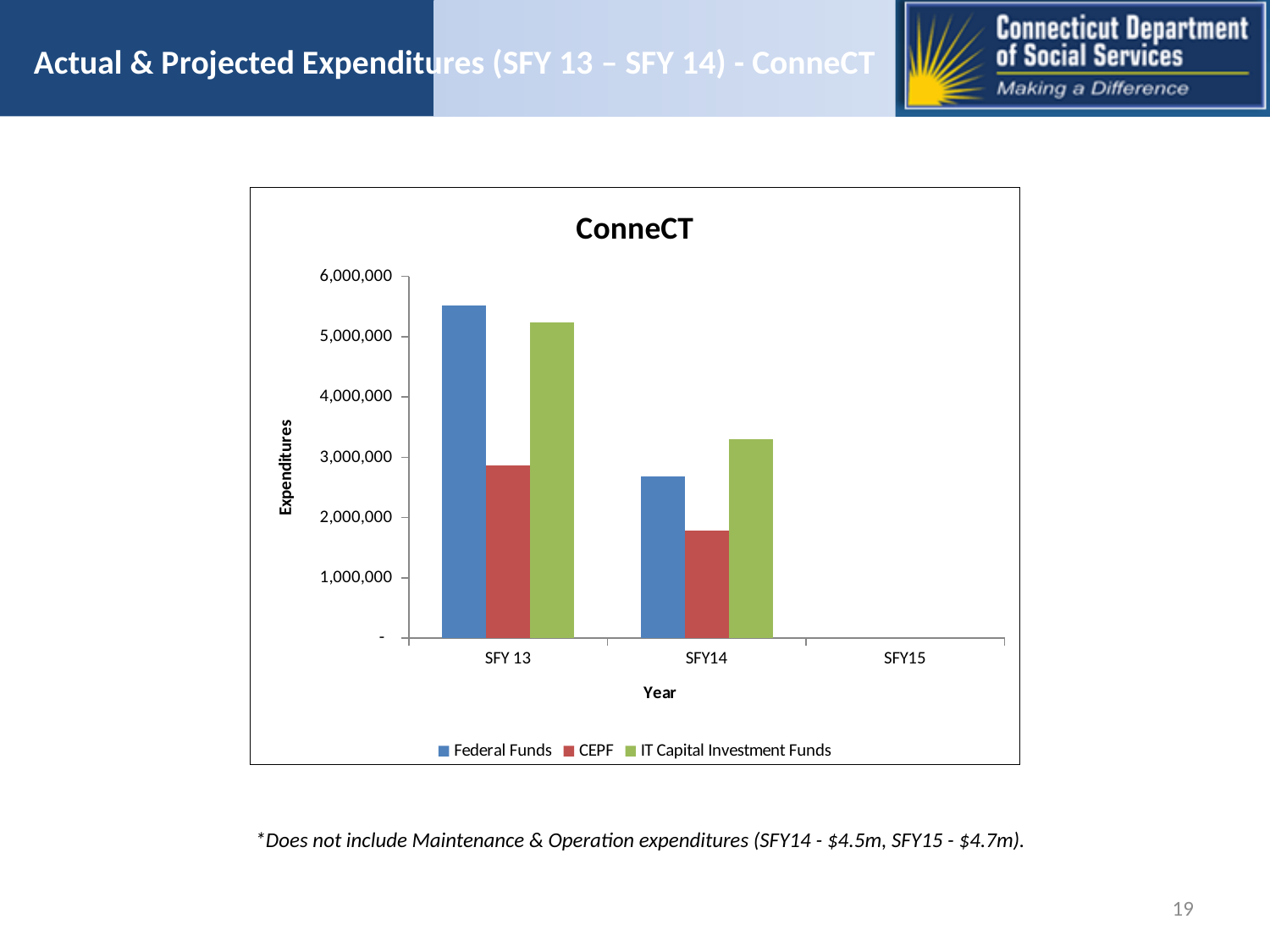
Which is larger: Federal Funds in SFY 13 or Federal Funds in SFY14? Federal Funds in SFY 13 How many series does the legend of the ConneCT chart list? 3 Which plotted bar is the lowest in the ConneCT chart? CEPF (SFY14) Is the IT Capital Investment Funds value for SFY14 greater or less than 3,000,000? greater Which series has the tallest bar in the ConneCT chart? Federal Funds (SFY 13) Do the Federal Funds expenditures rise or fall from SFY 13 to SFY14? fall Is the CEPF value for SFY 13 greater or less than 3,000,000? less What is the label on the vertical axis of the ConneCT chart? Expenditures Is the Federal Funds value for SFY 13 greater or less than 5,000,000? greater What kind of chart is shown on the slide? bar chart How many year categories are shown on the x axis of the ConneCT chart? 3